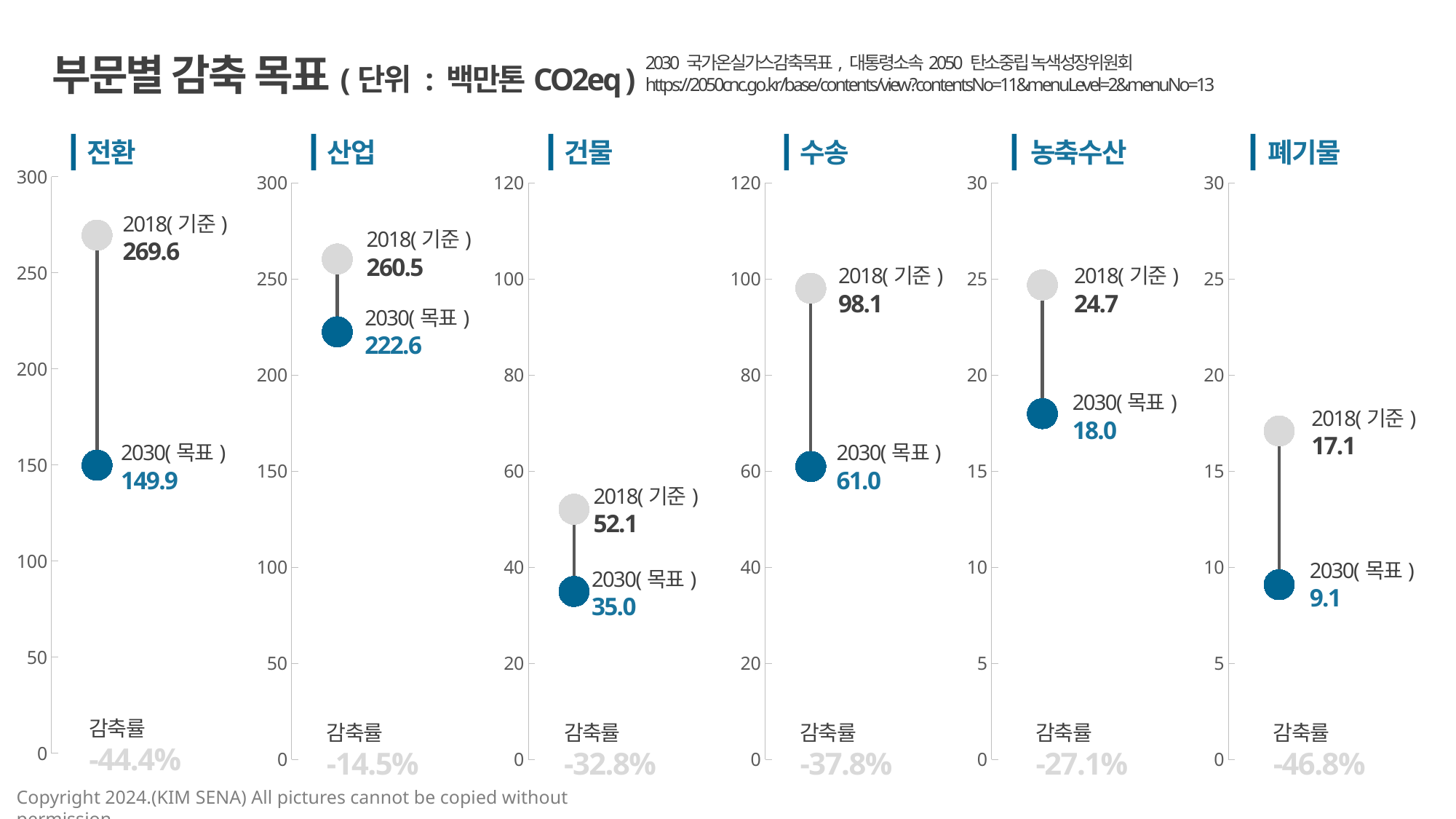
In the 건물 chart, what is the 2018(기준) value? 52.1 In the 산업 chart, what is the difference between the 2018(기준) value and the 2030(목표) value? 37.9 In the 전환 chart, what is the 2018(기준) value? 269.6 Across the six charts, which sector has the lowest 2030(목표) value? 폐기물 Across the six charts, which sector has the highest 2018(기준) value? 전환 In the 농축수산 chart, what is the difference between the 2018(기준) value and the 2030(목표) value? 6.7 In the 폐기물 chart, what is the 감축률 shown? -46.8% In the 수송 chart, what is the 2030(목표) value? 61.0 In the 전환 chart, what is the 2030(목표) value? 149.9 How many sector charts are shown on the slide? 6 In the 수송 chart, is the 2018(기준) value greater or less than the 2030(목표) value? greater In the 산업 chart, what is the 2030(목표) value? 222.6